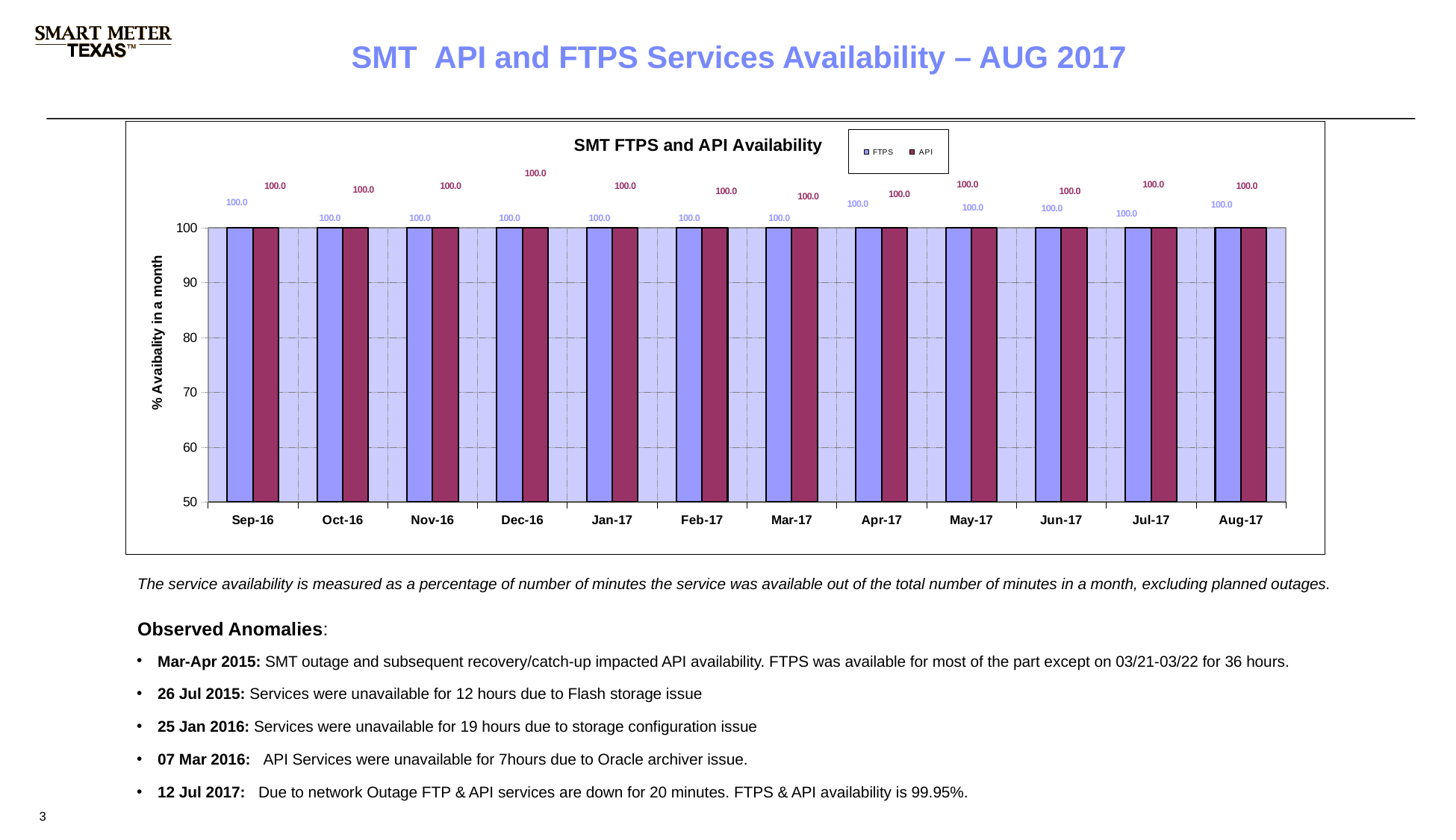
What is the API availability value for Aug-17? 100.0 Which two series are listed in the chart legend? FTPS and API What type of chart is shown on the slide? bar chart How many series does the chart legend list? 2 Is the API availability value for Jan-17 greater or less than 90? greater What is the FTPS availability value for Sep-16? 100.0 What is the FTPS availability value for Jul-17? 100.0 What is the title of the chart? SMT FTPS and API Availability What is the API availability value for Dec-16? 100.0 Do the FTPS availability values rise, fall, or stay flat from Sep-16 to Aug-17? stay flat How many months are shown on the x axis of the chart? 12 What is the difference between the FTPS and API availability values for Mar-17? 0.0